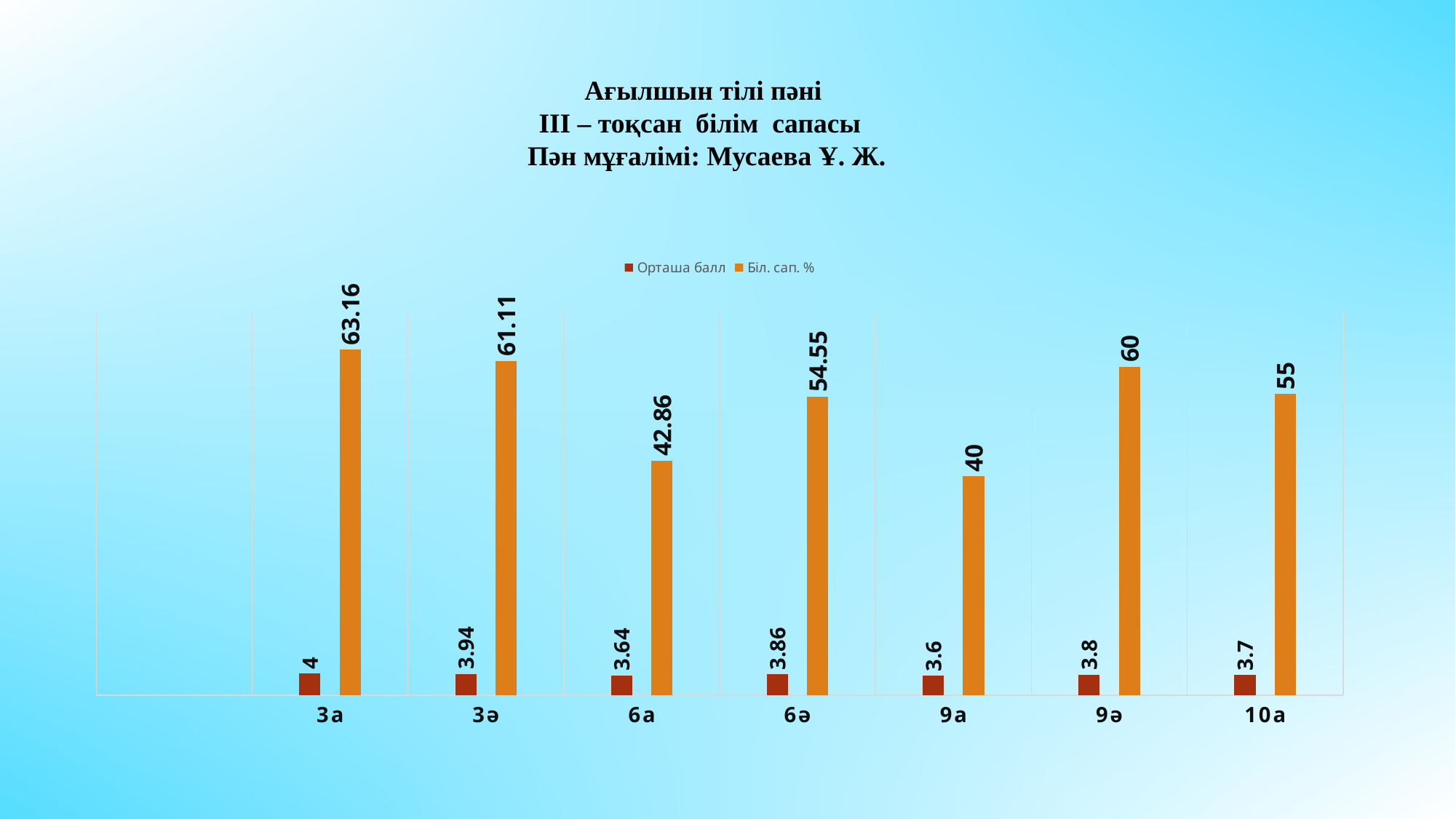
What is the Орташа балл value for 6ә? 3.86 What kind of chart is shown on the slide? bar chart Which category has the lowest Біл. сап. % value? 9а Which category has the lowest Орташа балл value? 9а How many series does the legend list? 2 What is the Біл. сап. % value for 9ә? 60 What are the two series names listed in the legend? Орташа балл and Біл. сап. % What is the Біл. сап. % value for 3а? 63.16 Which category has the highest Біл. сап. % value? 3а What is the difference between the Біл. сап. % values for 3а and 10а? 8.16 How many categories are shown on the x axis? 7 Which is larger, the Біл. сап. % value for 6а or for 6ә? 6ә